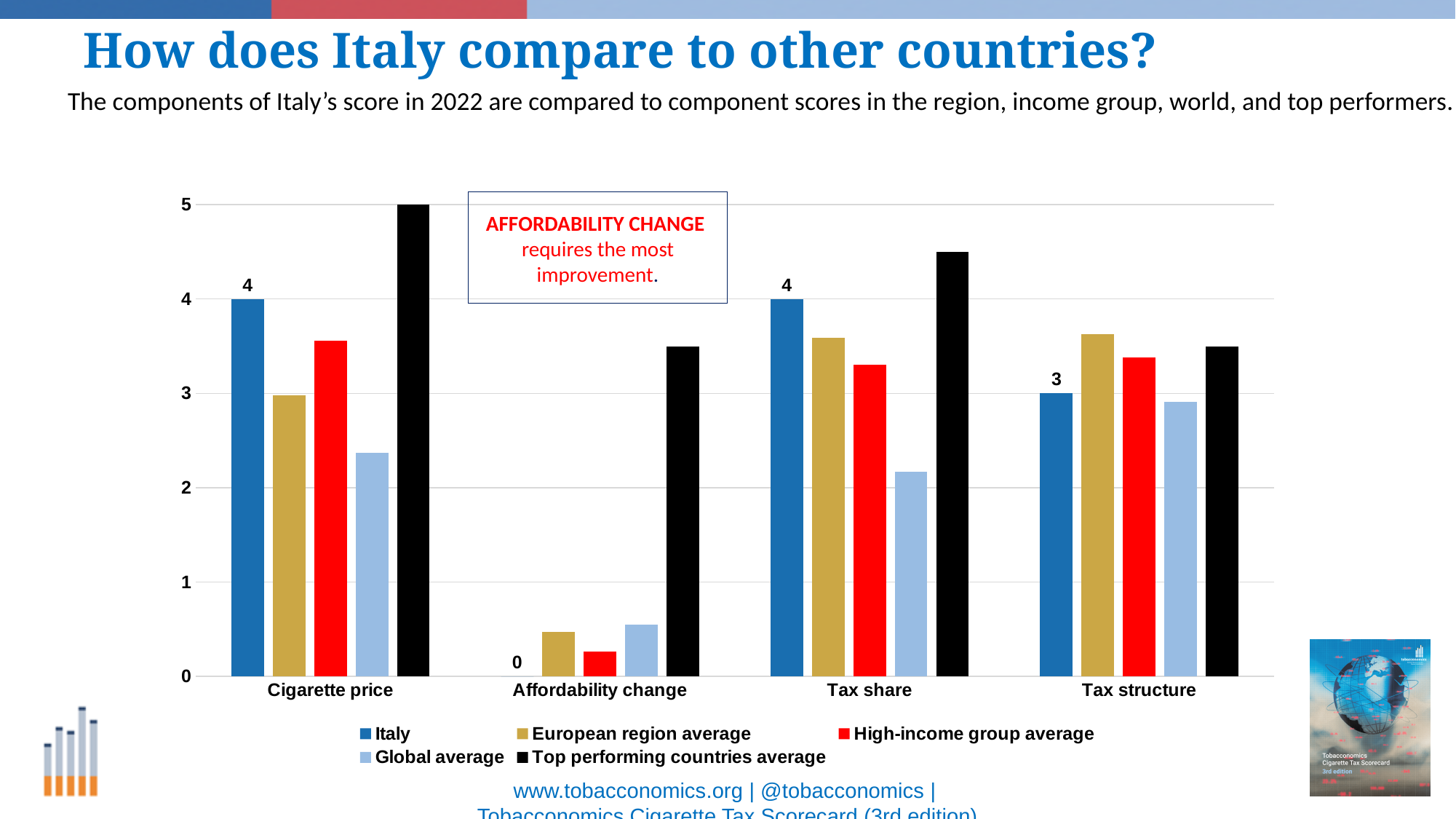
Which series is shown in black? Top performing countries average How many categories are shown on the x axis? 4 What is Italy's score for Tax structure? 3 Is the Global average for Cigarette price greater or less than 3? less Is the Top performing countries average for Tax share greater or less than 4? greater What is the Top performing countries average for Cigarette price? 5 In which category does Italy have its lowest score? Affordability change How many series does the legend list? 5 What is the difference between Italy's Cigarette price score and its Tax structure score? 1 What is Italy's score for Affordability change? 0 What is Italy's score for Cigarette price? 4 For Italy, which is higher: the Tax share score or the Tax structure score? Tax share